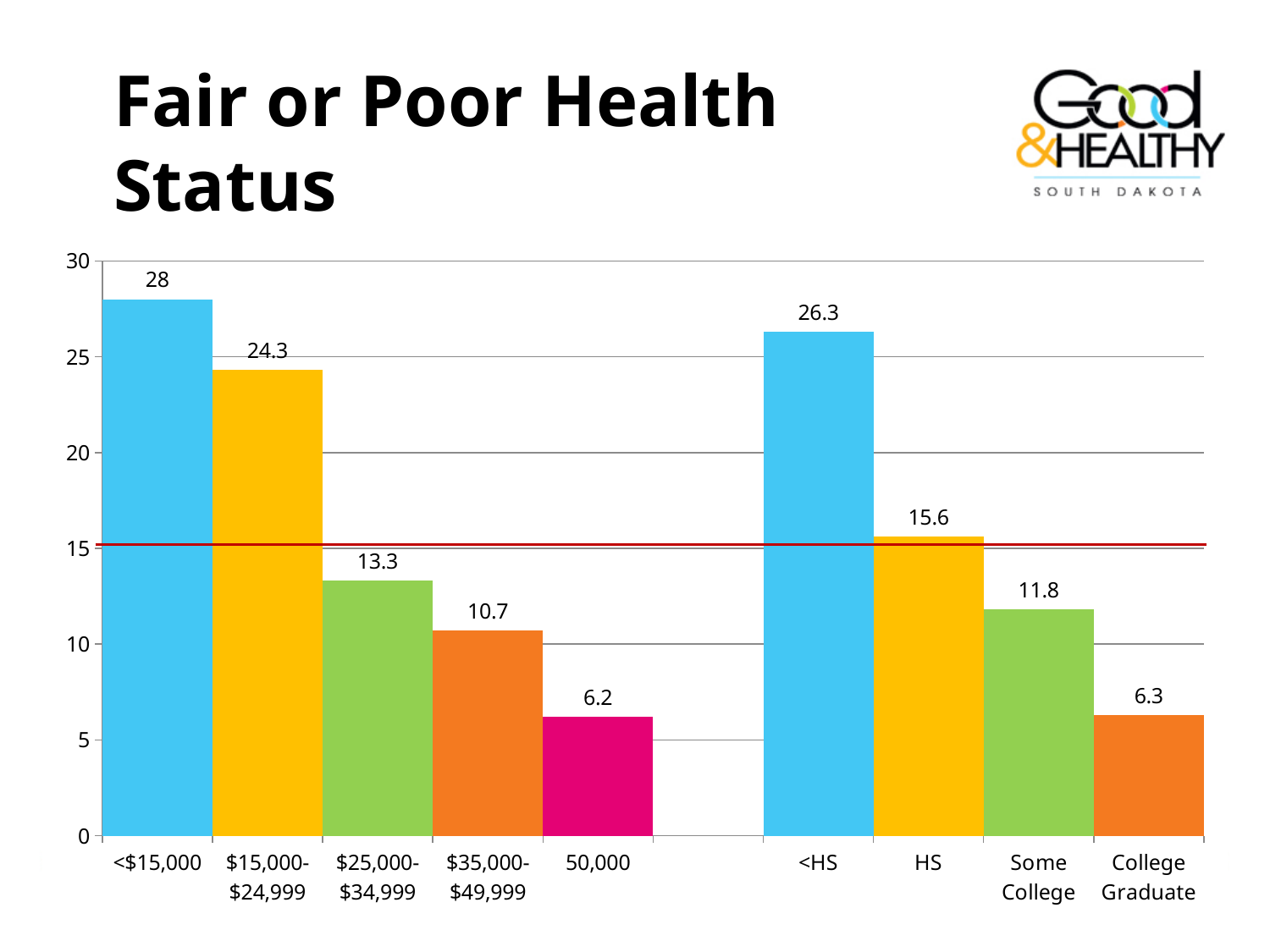
What is the value for the <HS education category? 26.3 What is the difference between the values for <$15,000 and $15,000-$24,999? 3.7 What is the difference between the values for <HS and HS? 10.7 Do the values rise or fall across the income categories from <$15,000 to 50,000? Fall Which category has the highest value on the chart? <$15,000 What is the value for the <$15,000 income category? 28 What kind of chart is shown on the slide? Bar chart What is the value for the $35,000-$49,999 income category? 10.7 How many bars are plotted on the chart? 9 What is the value for the Some College category? 11.8 Which category has the lowest value on the chart? 50,000 Which is larger, the value for HS or the value for $25,000-$34,999? HS